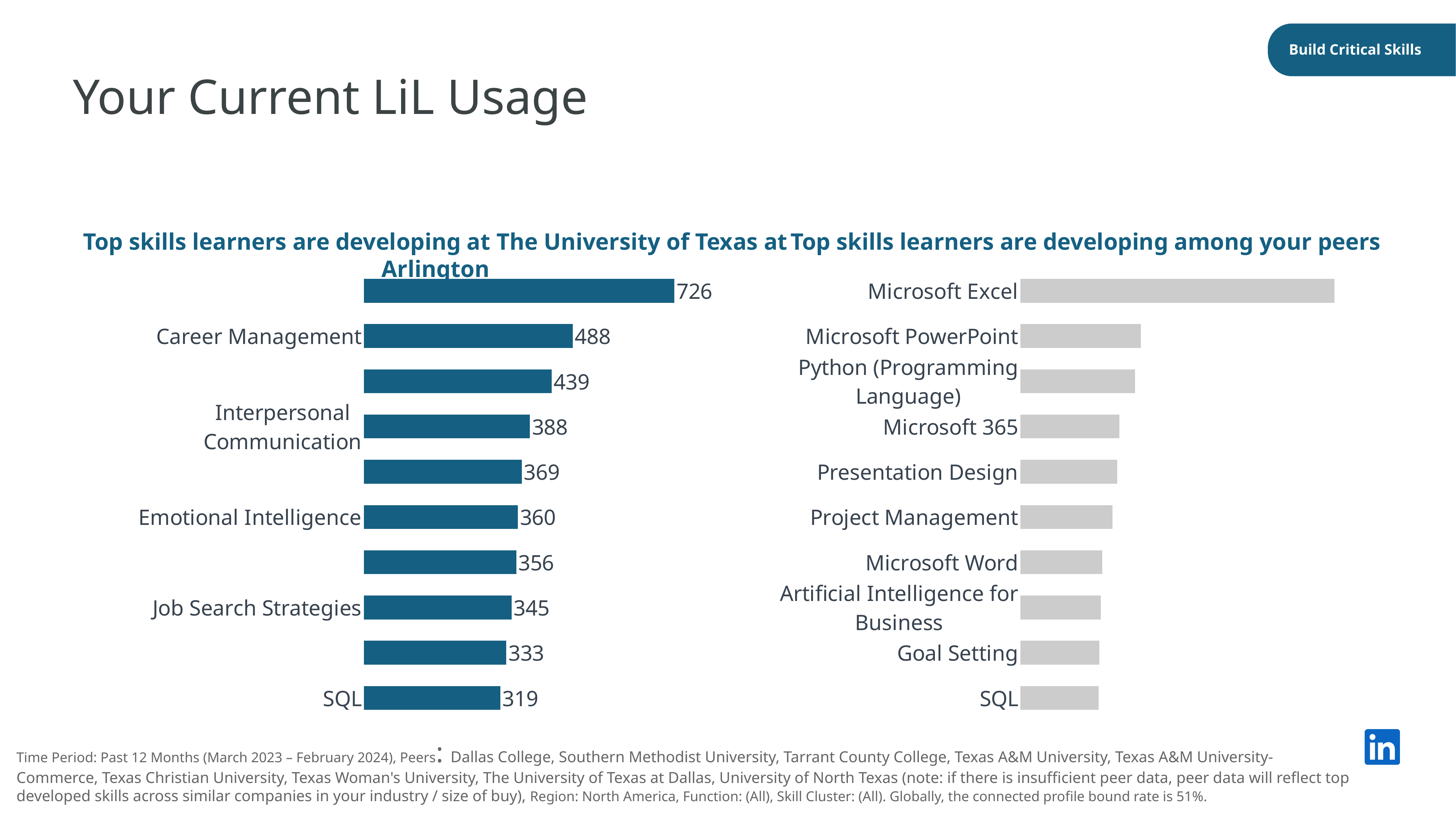
On the chart titled 'Top skills learners are developing at The University of Texas at Arlington', what is the value for Job Search Strategies? 345 On the chart titled 'Top skills learners are developing at The University of Texas at Arlington', what is the value for Interpersonal Communication? 388 On the chart titled 'Top skills learners are developing at The University of Texas at Arlington', what is the difference between the values for Career Management and SQL? 169 On the chart titled 'Top skills learners are developing at The University of Texas at Arlington', what is the value for Career Management? 488 On the chart titled 'Top skills learners are developing among your peers', which is larger, Microsoft PowerPoint or Microsoft Word? Microsoft PowerPoint On the chart titled 'Top skills learners are developing at The University of Texas at Arlington', how many bars are plotted? 10 On the chart titled 'Top skills learners are developing at The University of Texas at Arlington', which is larger, Emotional Intelligence or Job Search Strategies? Emotional Intelligence On the chart titled 'Top skills learners are developing at The University of Texas at Arlington', which labeled category has the lowest value? SQL What kind of chart is the one titled 'Top skills learners are developing among your peers'? Bar chart On the chart titled 'Top skills learners are developing at The University of Texas at Arlington', what is the largest value shown on any bar? 726 On the chart titled 'Top skills learners are developing among your peers', which category has the longest bar? Microsoft Excel On the chart titled 'Top skills learners are developing at The University of Texas at Arlington', what is the value for SQL? 319